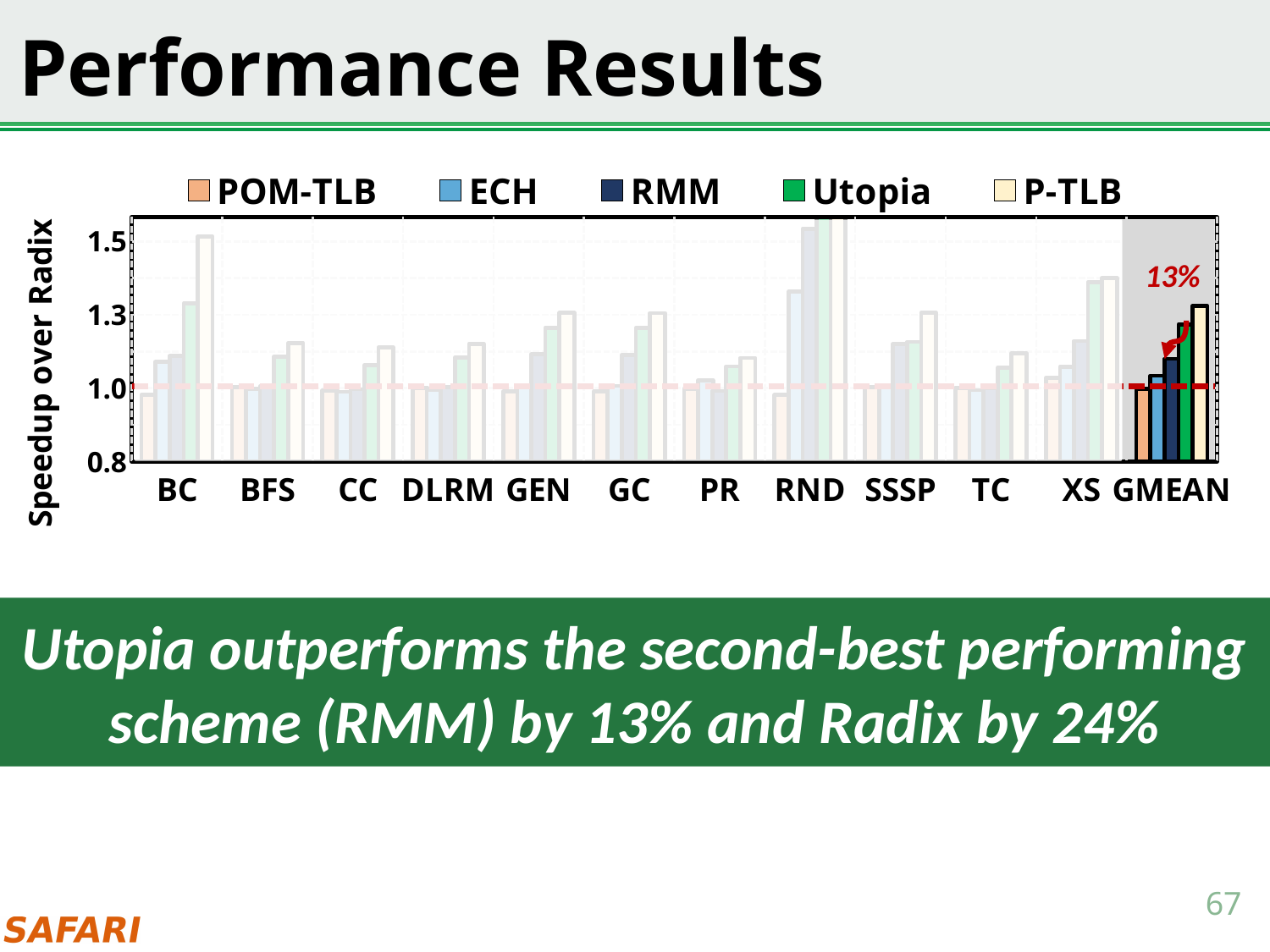
Is the P-TLB value for BC greater or less than 1.3? greater What is the label of the y axis? Speedup over Radix How many series does the legend list? 5 Which category has the highest Utopia bar? RND Is the Utopia value for GMEAN greater or less than 1.0? greater What kind of chart is shown on the slide? bar chart Is the ECH value for RND greater or less than 1.3? greater Which series is shown in green in the legend? Utopia How many categories are shown along the x axis? 12 For GMEAN, which is larger: the Utopia value or the POM-TLB value? Utopia